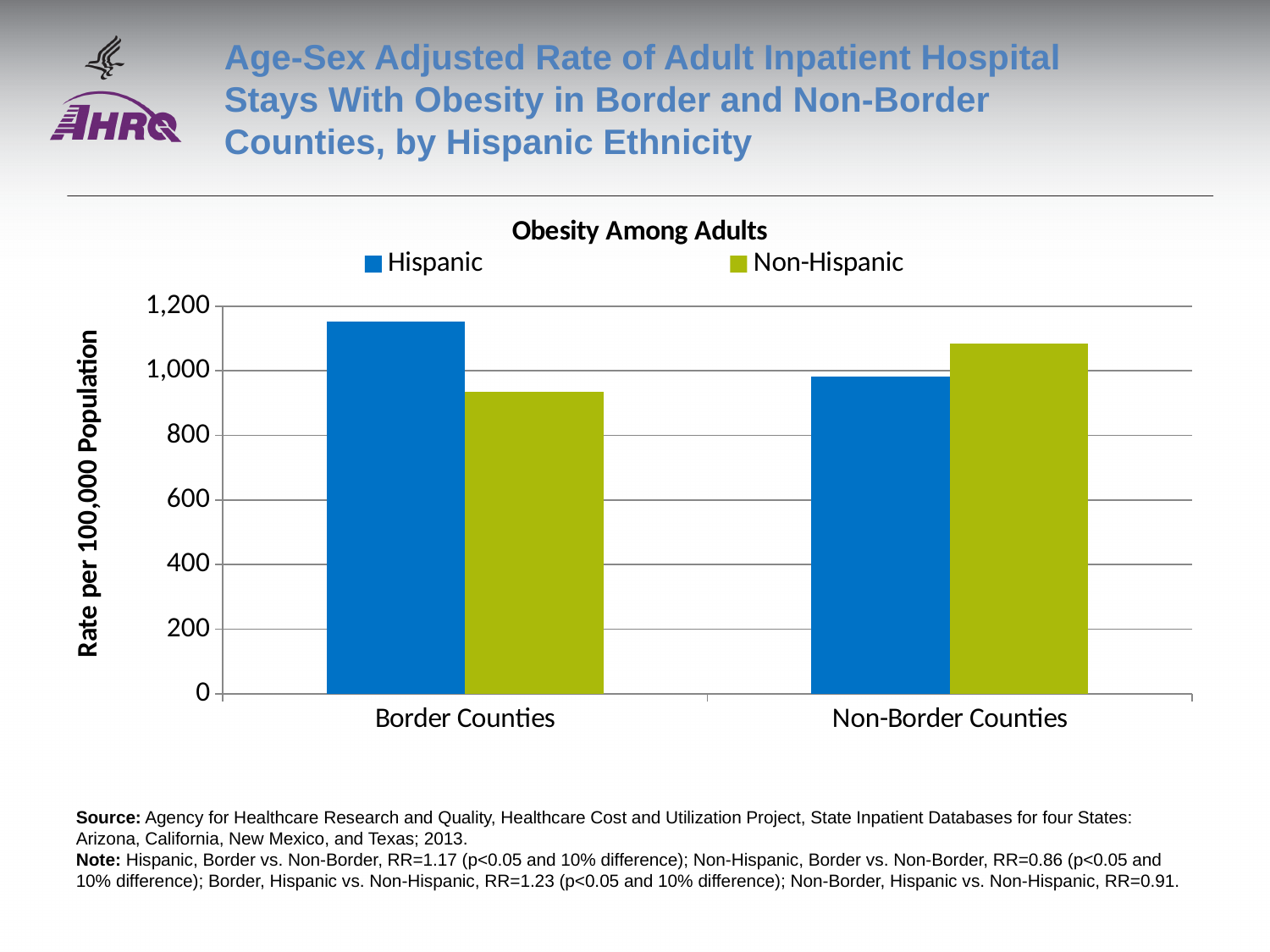
Which bar is the highest in the chart? Hispanic, Border Counties What kind of chart is shown on the slide? Bar chart What is the label on the vertical axis? Rate per 100,000 Population In Non-Border Counties, which group has the higher rate, Hispanic or Non-Hispanic? Non-Hispanic How many series does the legend list? 2 Is the value for Hispanic in Non-Border Counties greater or less than 800? greater Is the value for Non-Hispanic in Border Counties greater or less than 1,000? less How many county categories are shown on the x axis? 2 Is the value for Hispanic in Border Counties greater or less than 1,000? greater In Border Counties, which group has the higher rate, Hispanic or Non-Hispanic? Hispanic For the Hispanic series, is the rate higher in Border Counties or Non-Border Counties? Border Counties